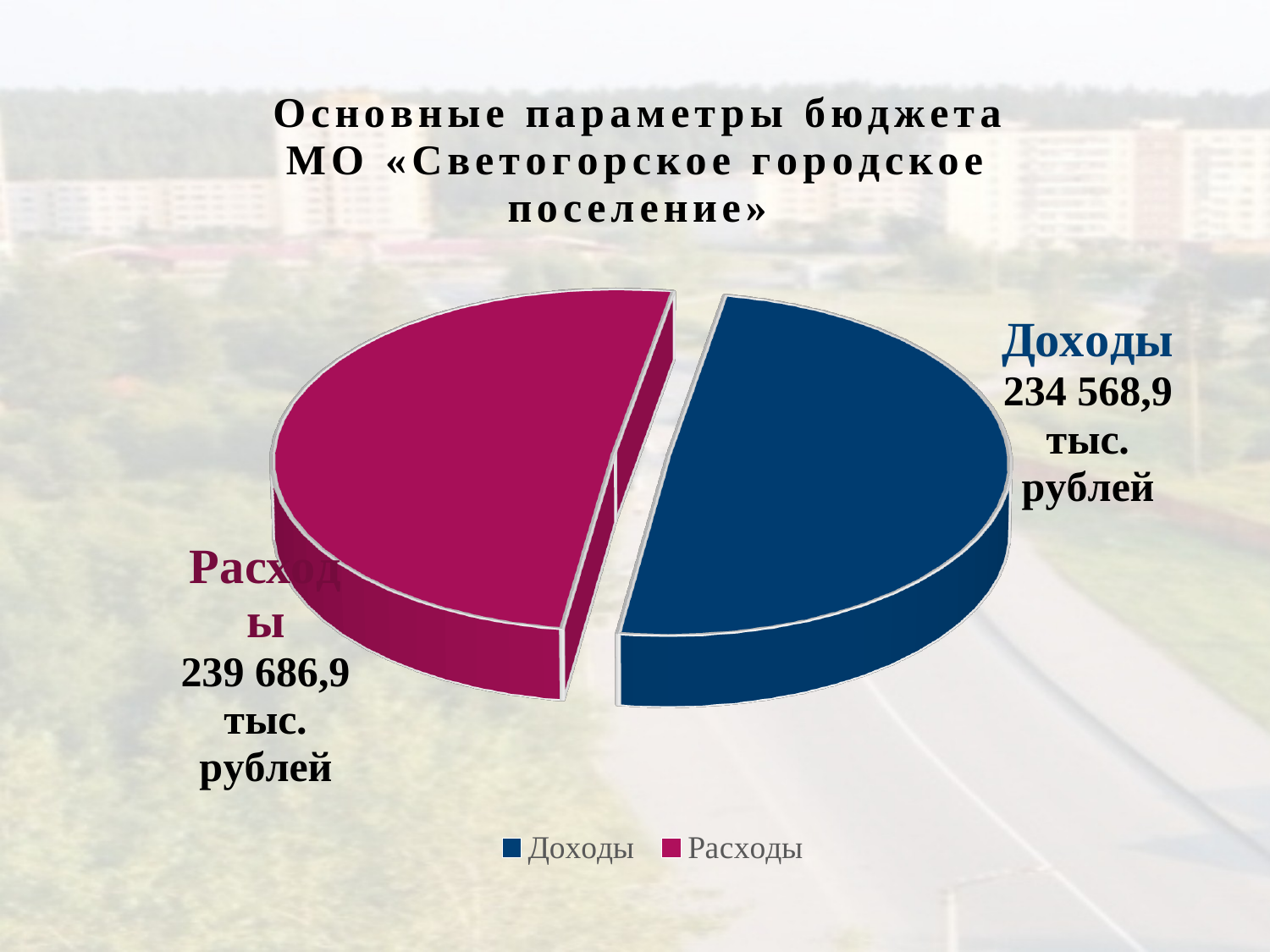
Which category has the larger value, Доходы or Расходы? Расходы What type of chart is shown on the slide? Pie chart What is the title of the chart? Основные параметры бюджета МО «Светогорское городское поселение» What colour is the Доходы slice in the pie chart? Blue Which slice of the pie chart has the lowest value? Доходы What is the value shown for Доходы? 234 568,9 тыс. рублей How many slices does the pie chart have? 2 What is the difference between Расходы and Доходы? 5 118,0 тыс. рублей Which slice of the pie chart has the highest value? Расходы What is the total of Доходы and Расходы shown on the chart? 474 255,8 тыс. рублей How many entries does the legend list? 2 What is the value shown for Расходы? 239 686,9 тыс. рублей